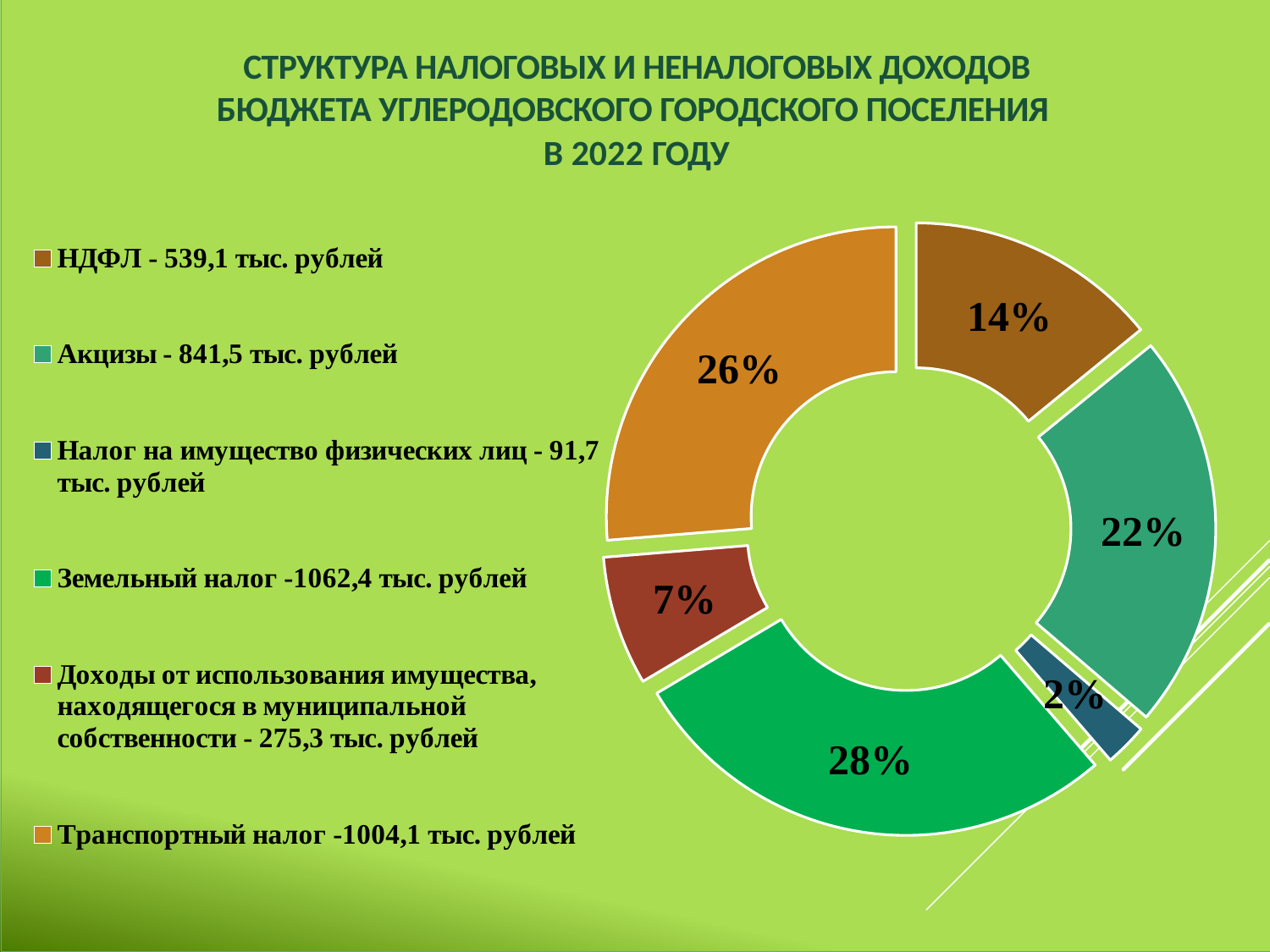
What share of the chart does Акцизы represent? 22% Which category has the largest share of the chart? Земельный налог What is the difference in percentage points between the shares of Земельный налог and НДФЛ? 14 percentage points Which category has the smallest share of the chart? Налог на имущество физических лиц What is the value for Акцизы given in the legend? 841,5 тыс. рублей What kind of chart is shown on the slide? Doughnut (pie) chart What share of the chart does НДФЛ represent? 14% What is the value for Транспортный налог given in the legend? 1004,1 тыс. рублей What share of the chart does Транспортный налог represent? 26% Which has a larger share: Транспортный налог or Акцизы? Транспортный налог How many categories does the legend list? 6